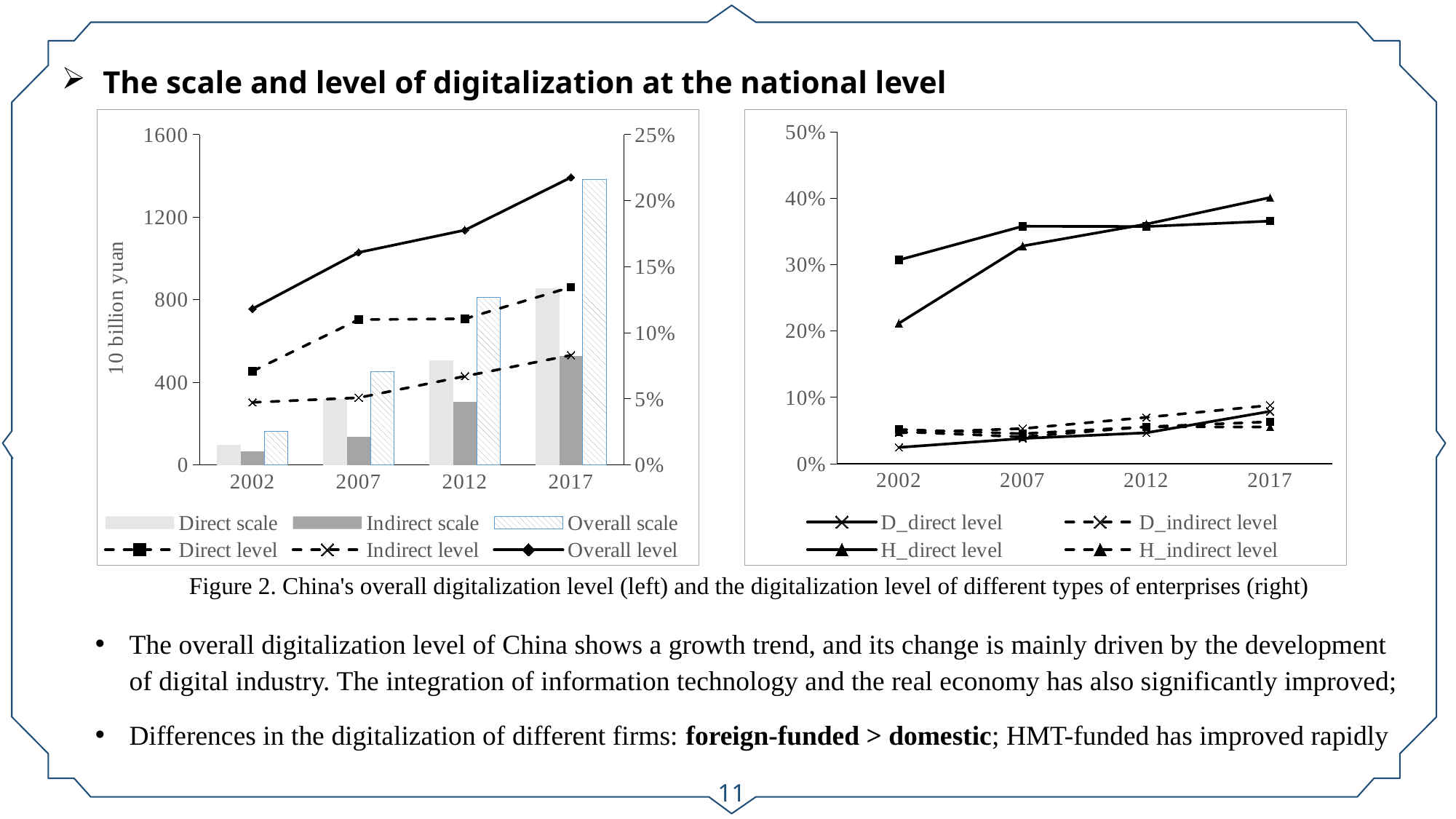
On the right chart, does the H_direct level rise or fall from 2002 to 2017? rise On the left chart, does the Overall level rise or fall from 2002 to 2017? rise On the left chart, what is the label of the left vertical axis? 10 billion yuan On the left chart, is the Overall level for 2017 greater or less than 20%? greater On the left chart, which is larger in 2017, the Direct scale bar or the Indirect scale bar? Direct scale On the right chart, how many series does the legend list? 4 On the left chart, is the Overall scale bar for 2017 greater or less than 1200? greater On the left chart, how many years are shown on the x axis? 4 On the left chart, is the Direct scale bar for 2002 greater or less than 400? less On the left chart, in which year is the Overall scale bar highest? 2017 On the left chart, how many series does the legend list? 6 What kind of chart is the right chart? line chart